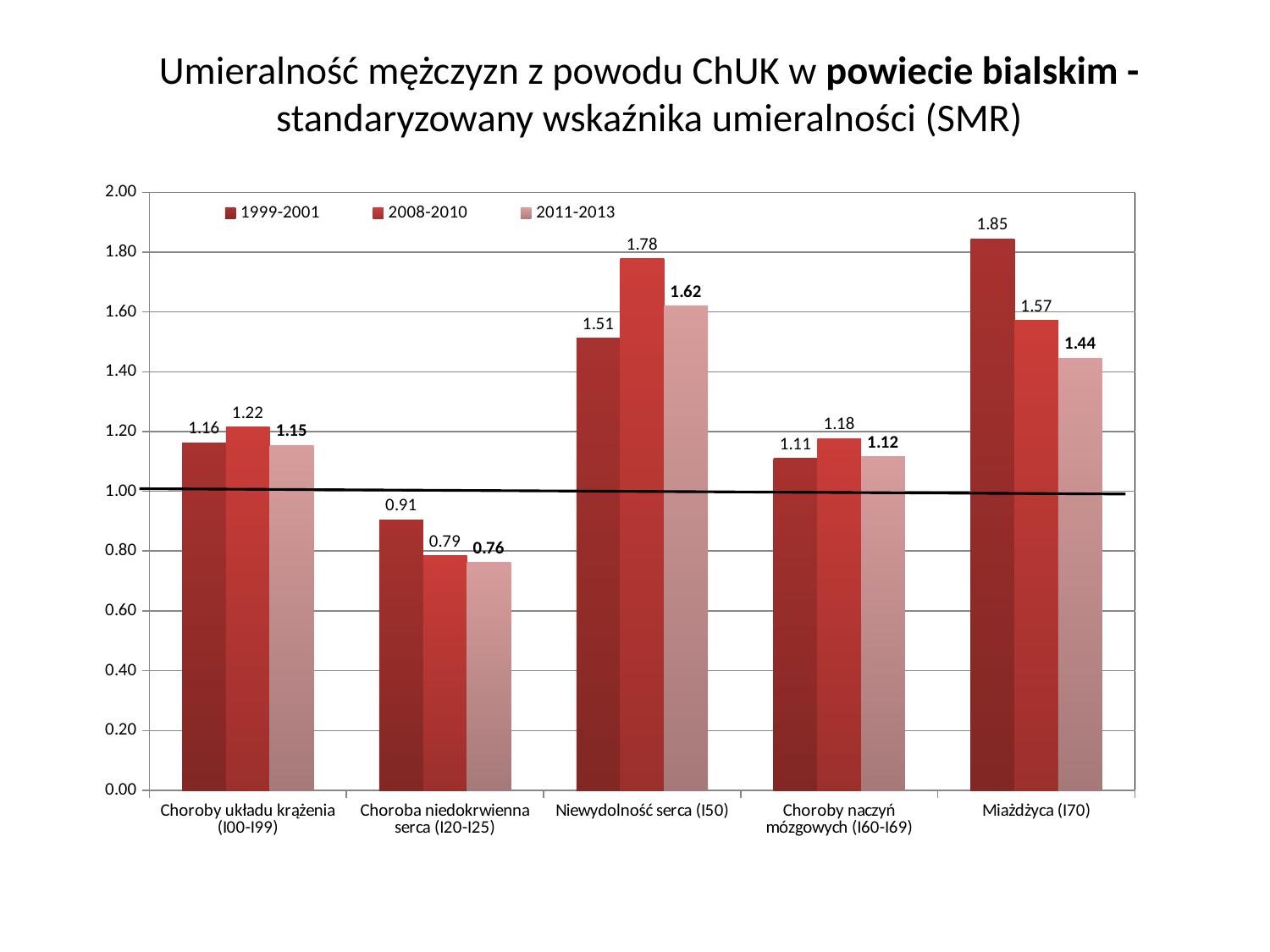
Which category has the highest value in the 1999-2001 series? Miażdżyca (I70) Do the values for Miażdżyca (I70) rise or fall from 1999-2001 to 2011-2013? fall How many series does the legend list? 3 What kind of chart is shown on the slide? bar chart Which is larger for Choroby naczyń mózgowych (I60-I69): the 2008-2010 value or the 1999-2001 value? 2008-2010 What is the value for Niewydolność serca (I50) in the 2008-2010 series? 1.78 What is the value for Miażdżyca (I70) in the 1999-2001 series? 1.85 How many categories are shown on the x axis? 5 Which category has the lowest value in the 2011-2013 series? Choroba niedokrwienna serca (I20-I25) What is the difference between the 1999-2001 and 2011-2013 values for Miażdżyca (I70)? 0.41 Is the 2011-2013 value for Niewydolność serca (I50) greater or less than 1.40? greater What is the value for Choroba niedokrwienna serca (I20-I25) in the 2011-2013 series? 0.76